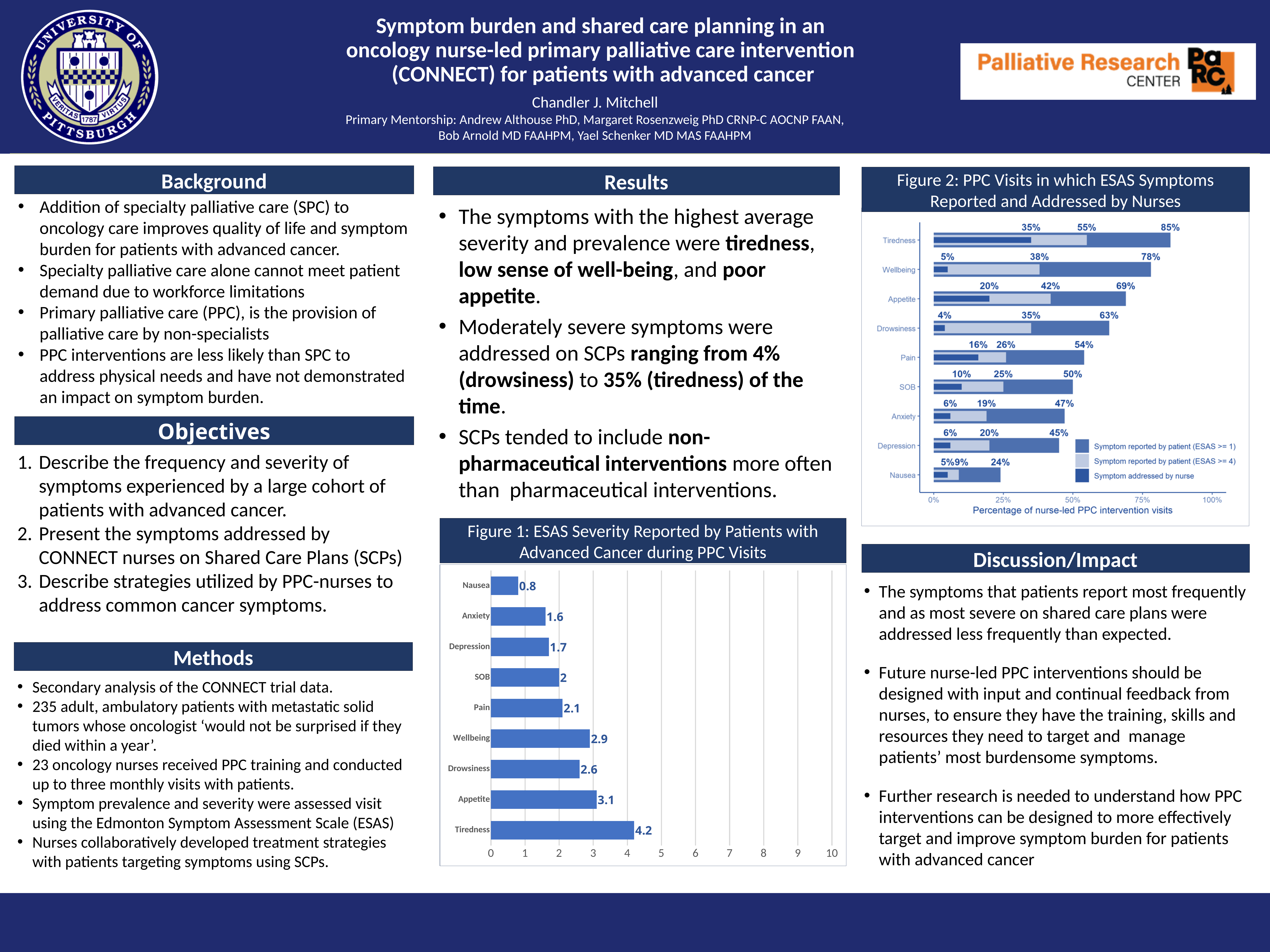
In Figure 2 (PPC Visits in which ESAS Symptoms Reported and Addressed by Nurses), how many series does the legend list? 3 In Figure 1 (ESAS Severity Reported by Patients), what is the value for Tiredness? 4.2 In Figure 2 (PPC Visits in which ESAS Symptoms Reported and Addressed by Nurses), what percentage of visits had Tiredness reported by the patient with ESAS >= 1? 85% In Figure 1 (ESAS Severity Reported by Patients), what is the value for Appetite? 3.1 In Figure 2 (PPC Visits in which ESAS Symptoms Reported and Addressed by Nurses), what is the difference between the percentage of visits with Wellbeing reported (ESAS >= 1) and Wellbeing addressed by the nurse? 73% What kind of chart is Figure 1 (ESAS Severity Reported by Patients)? Bar chart In Figure 1 (ESAS Severity Reported by Patients), what is the difference between the values for Tiredness and Nausea? 3.4 In Figure 1 (ESAS Severity Reported by Patients), which symptom has the lowest value? Nausea In Figure 1 (ESAS Severity Reported by Patients), how many symptoms are plotted? 9 In Figure 2 (PPC Visits in which ESAS Symptoms Reported and Addressed by Nurses), what percentage of visits had Drowsiness addressed by the nurse? 4% In Figure 2 (PPC Visits in which ESAS Symptoms Reported and Addressed by Nurses), which symptom has the highest percentage of visits addressed by the nurse? Tiredness In Figure 1 (ESAS Severity Reported by Patients), which is larger, the value for Wellbeing or the value for Drowsiness? Wellbeing